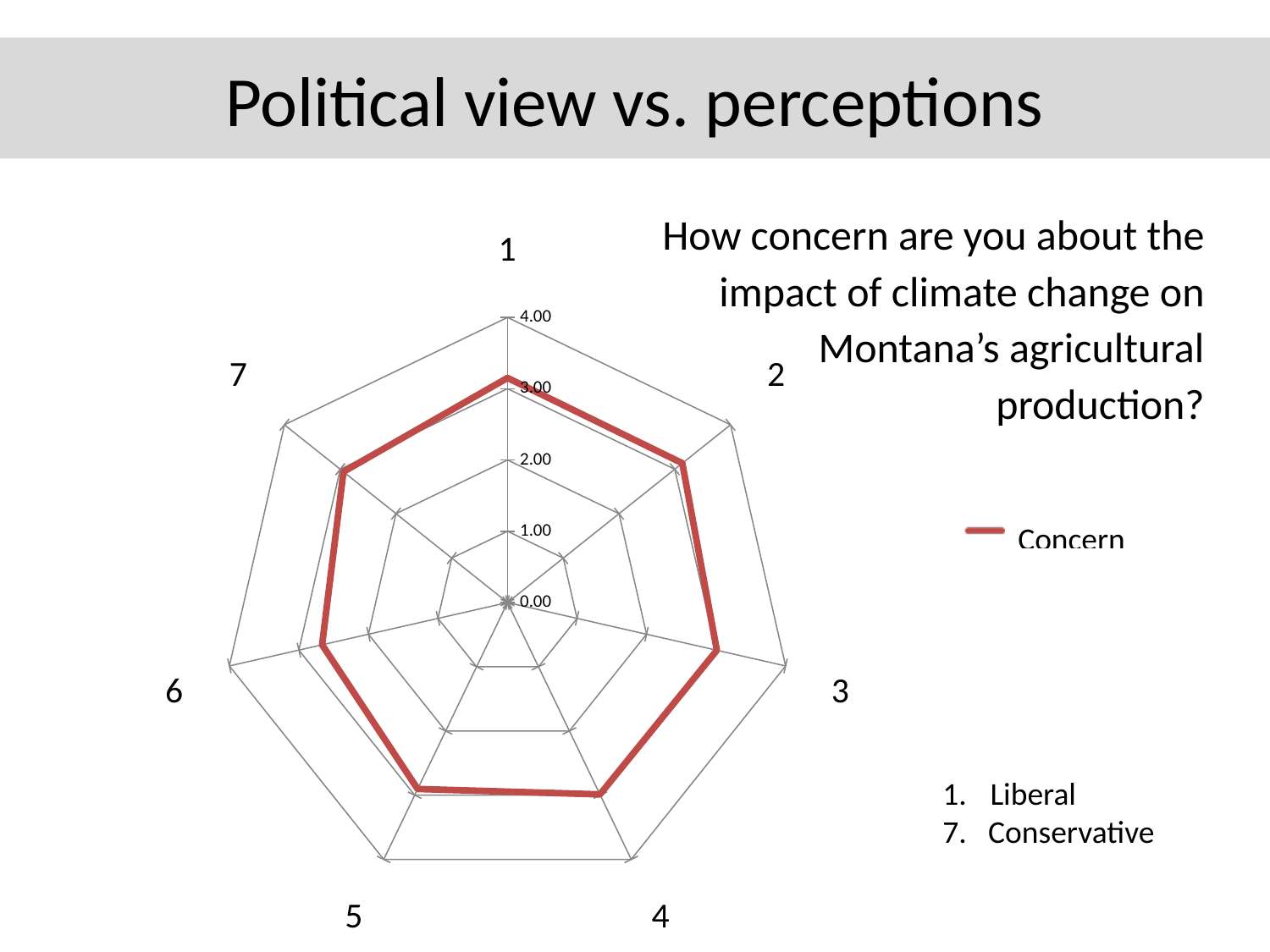
Is the Concern value for category 4 greater or less than 2.00? greater Is the Concern value for category 1 greater or less than 3.00? greater What is the name of the series shown in the legend? Concern Which has the larger Concern value, category 1 or category 6? category 1 How many series does the legend of the radar chart list? 1 How many categories (political view points) are plotted on the radar chart? 7 Is the Concern value for category 7 greater or less than 2.00? greater Which has the larger Concern value, category 3 or category 6? category 3 What kind of chart is shown on the slide? radar chart Which category has the lowest Concern value on the radar chart? 6 What is the maximum value shown on the radar chart's axis? 4.00